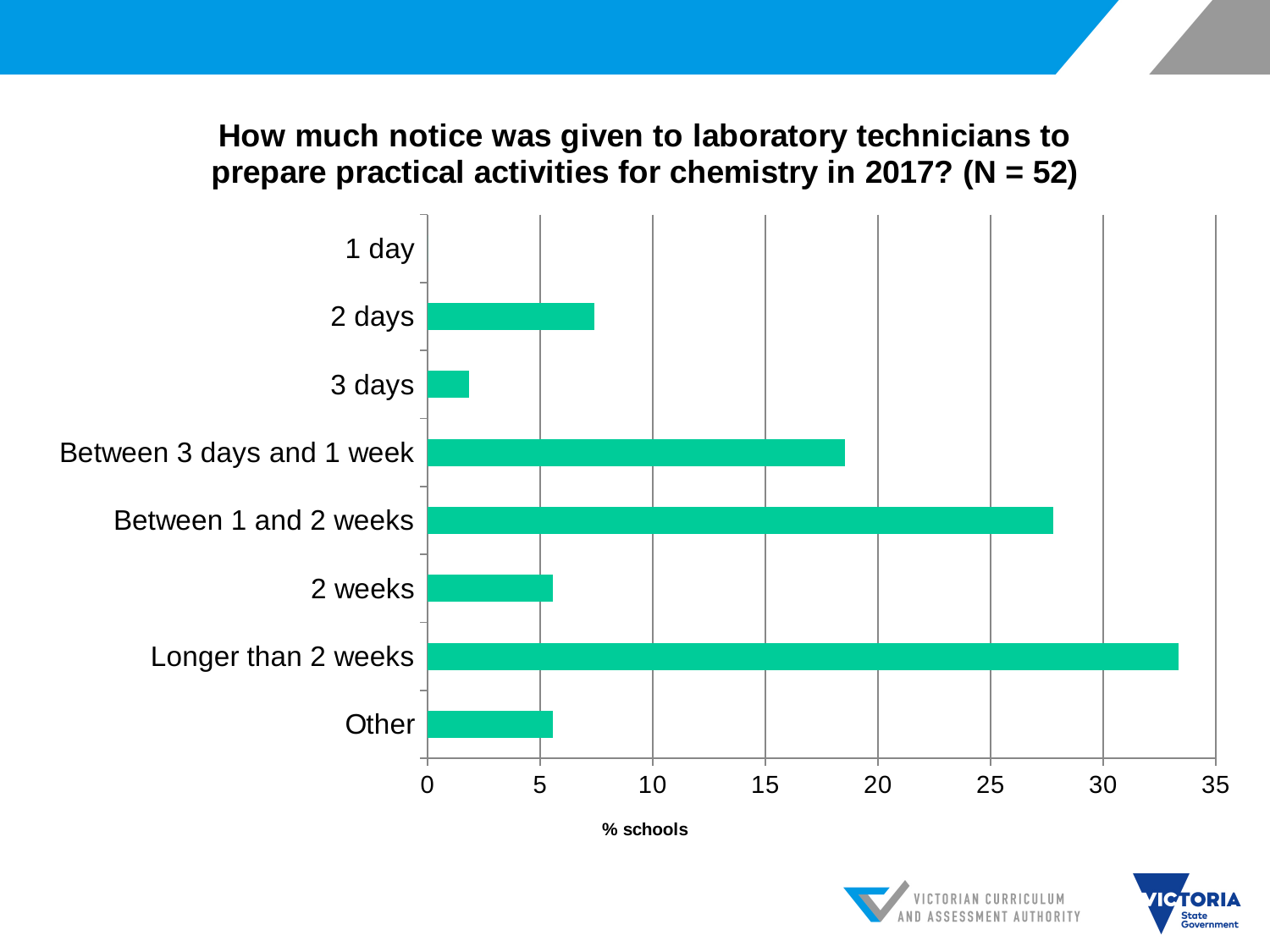
Is the value for 'Longer than 2 weeks' greater or less than 30? greater Which category has the highest percentage of schools? Longer than 2 weeks Which is larger, the value for 'Between 1 and 2 weeks' or the value for 'Between 3 days and 1 week'? Between 1 and 2 weeks Which is larger, the value for '2 days' or the value for '3 days'? 2 days Is the value for '2 days' greater or less than 10? less Which category has the lowest percentage of schools? 1 day What kind of chart is shown on the slide? bar chart Is the value for '3 days' greater or less than 5? less What is the label on the horizontal axis of the chart? % schools How many notice-period categories are shown on the chart? 8